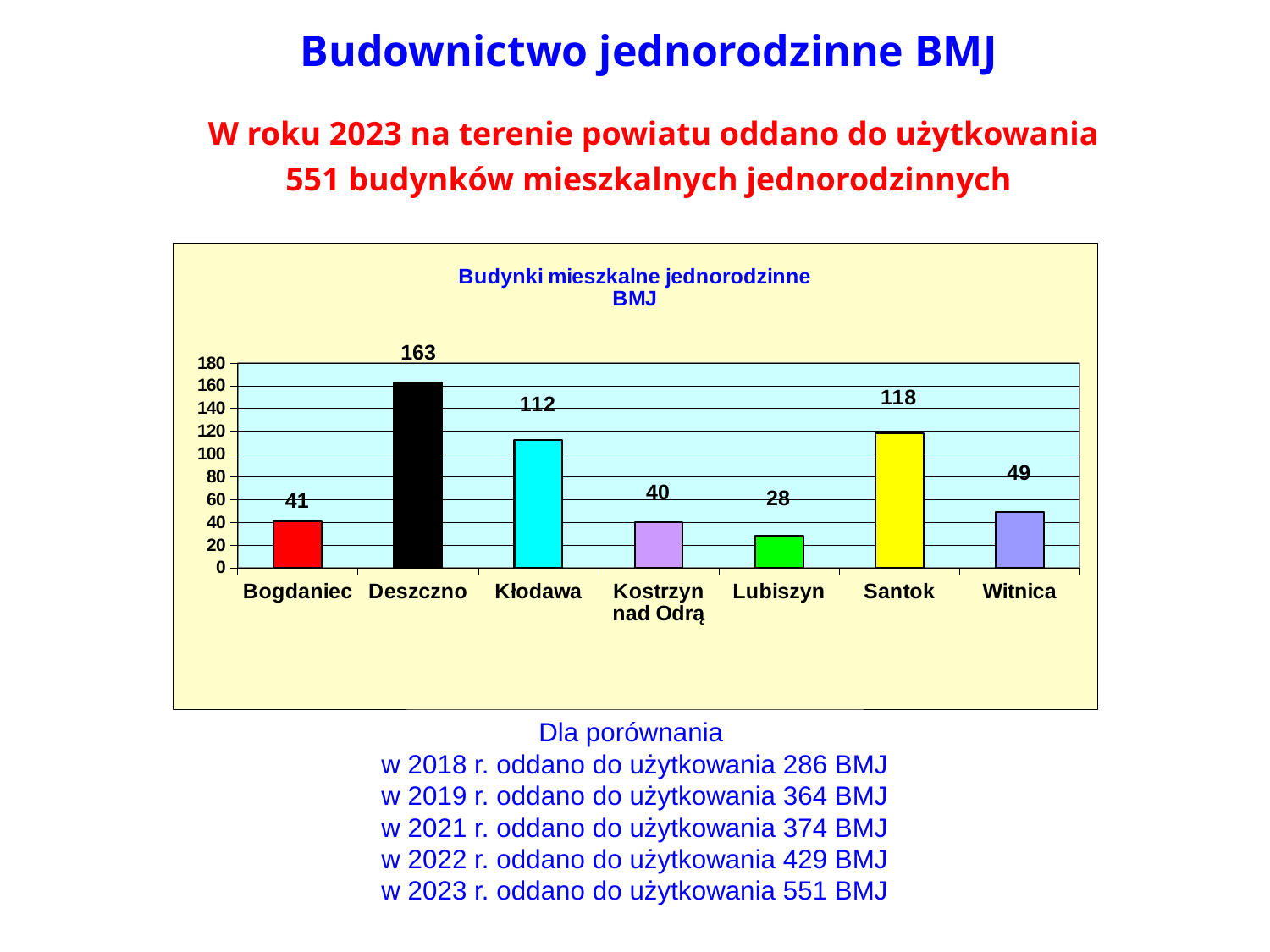
What is the difference between the values for Deszczno and Santok? 45 What is the title of the chart? Budynki mieszkalne jednorodzinne BMJ What is the value for Kostrzyn nad Odrą? 40 What is the value for Witnica? 49 Which category has the highest value? Deszczno How many categories are shown on the x axis? 7 Which category has the lowest value? Lubiszyn Is the value for Santok greater or less than 100? greater Which is larger, the value for Santok or the value for Kłodawa? Santok What kind of chart is shown on the slide? bar chart What is the difference between the values for Kłodawa and Bogdaniec? 71 What is the value for Deszczno? 163